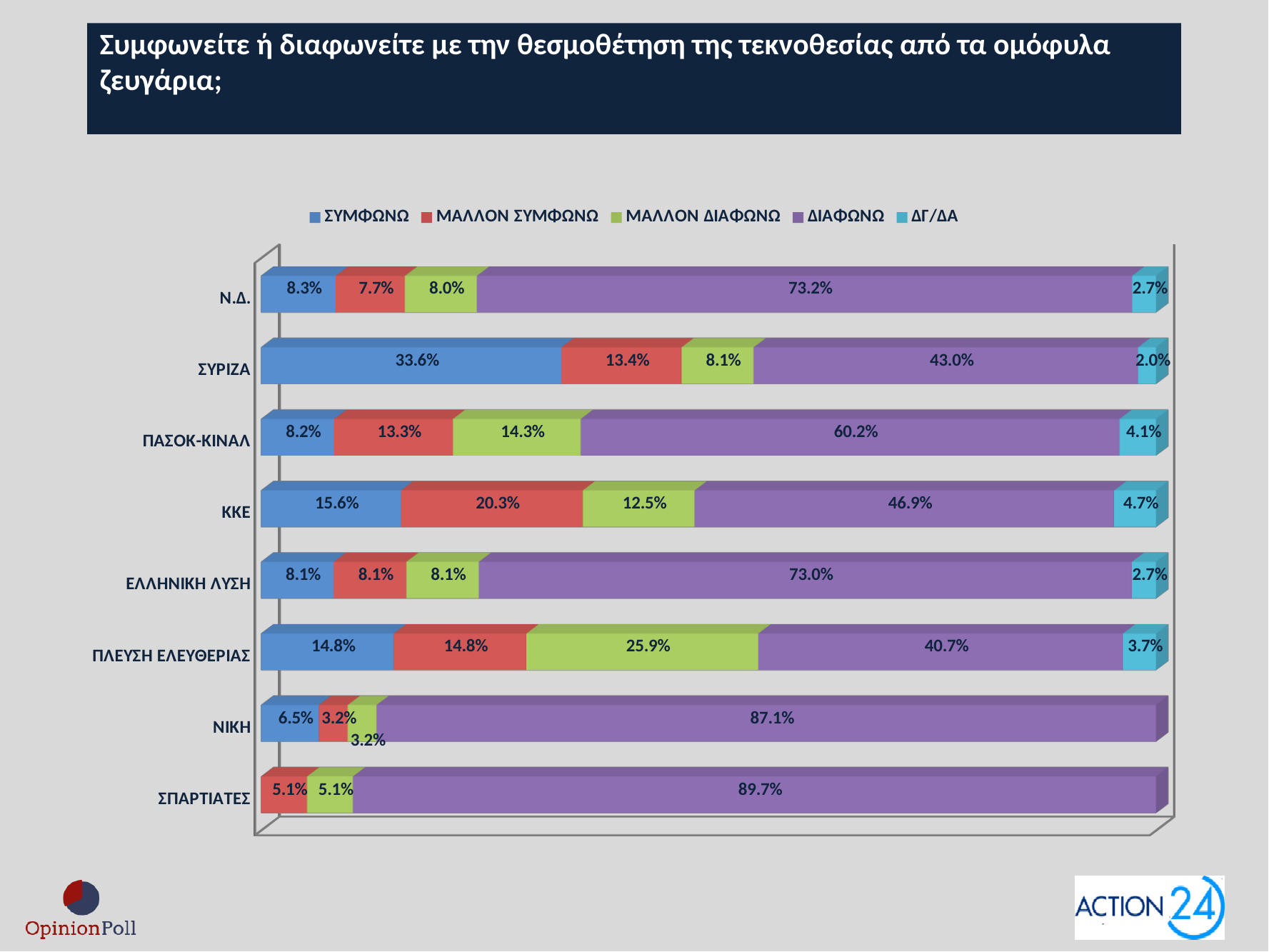
What is the ΜΑΛΛΟΝ ΔΙΑΦΩΝΩ value for ΠΛΕΥΣΗ ΕΛΕΥΘΕΡΙΑΣ? 25.9% What is the difference between the ΔΙΑΦΩΝΩ values for ΠΑΣΟΚ-ΚΙΝΑΛ and ΚΚΕ? 13.3% How many series does the legend list? 5 Which party has the highest ΣΥΜΦΩΝΩ value? ΣΥΡΙΖΑ Which party has the highest ΔΙΑΦΩΝΩ value? ΣΠΑΡΤΙΑΤΕΣ What is the total of the stacked bar for ΚΚΕ? 100.0% How many parties are shown on the chart? 8 Which is larger: the ΜΑΛΛΟΝ ΣΥΜΦΩΝΩ value for ΚΚΕ or for ΠΑΣΟΚ-ΚΙΝΑΛ? ΚΚΕ What is the ΔΓ/ΔΑ value for ΚΚΕ? 4.7% What percentage of Ν.Δ. voters answered ΔΙΑΦΩΝΩ? 73.2% What is the ΣΥΜΦΩΝΩ value for ΣΥΡΙΖΑ? 33.6% Which party has the lowest ΔΙΑΦΩΝΩ value? ΠΛΕΥΣΗ ΕΛΕΥΘΕΡΙΑΣ